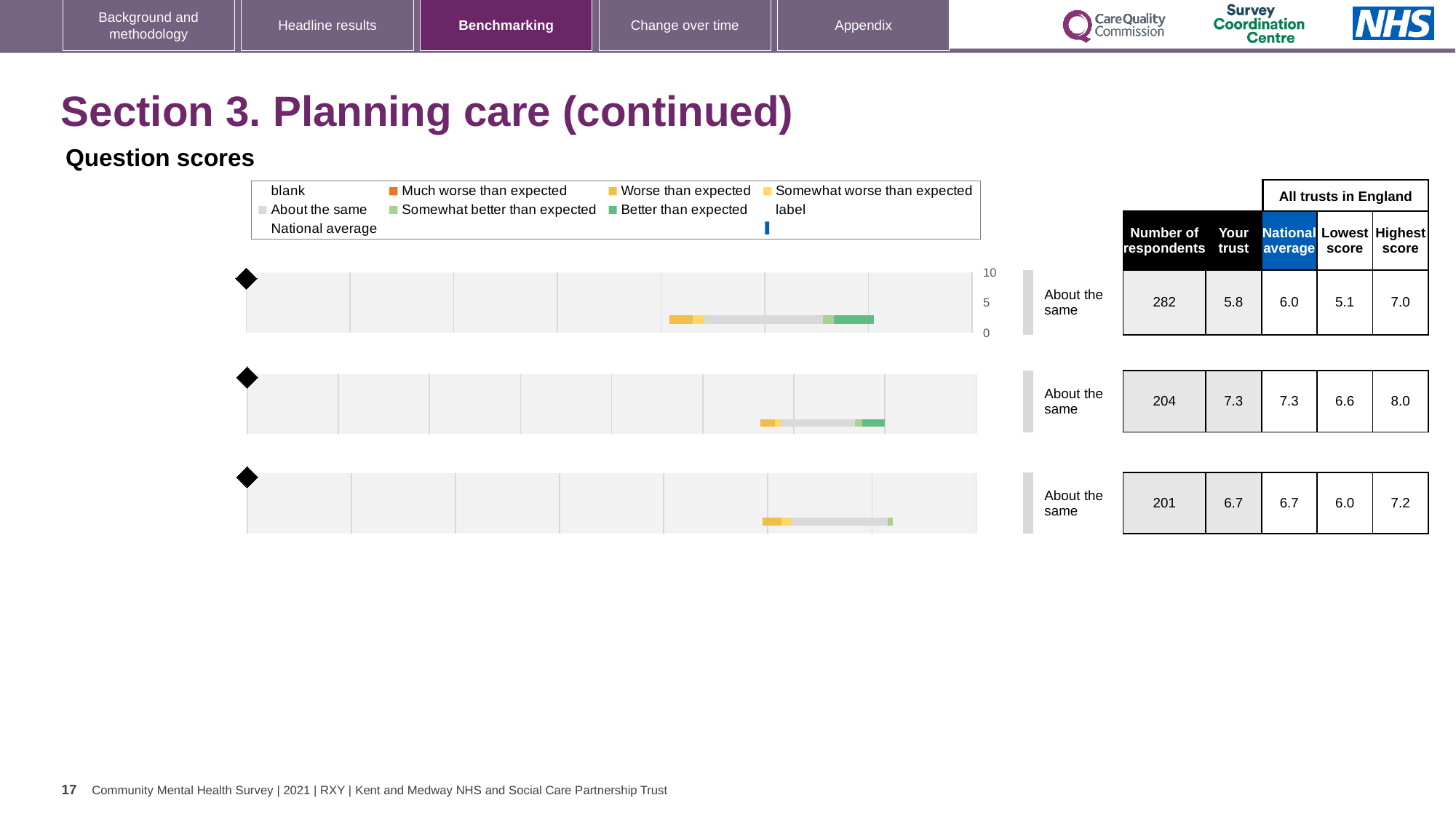
For the bottom chart, what is the highest score among all trusts in England? 7.2 For the middle chart, what is the difference between the highest score (8.0) and the lowest score (6.6)? 1.4 What benchmark category label is shown next to each of the three charts? About the same For the top chart, what is the difference between the highest score (7.0) and the lowest score (5.1)? 1.9 How many benchmarking bar charts are shown on the slide? 3 For the top chart, how many respondents are listed? 282 Which chart (top, middle or bottom) has the highest 'Your trust' score? Middle For the top chart, what is the 'Your trust' score shown in the table? 5.8 What kind of chart is used to show the question scores on this slide? Bar chart For the top chart, which is larger: the 'Your trust' score or the national average? National average For the middle chart, what is the national average score? 7.3 For the bottom chart, what is the lowest score among all trusts in England? 6.0